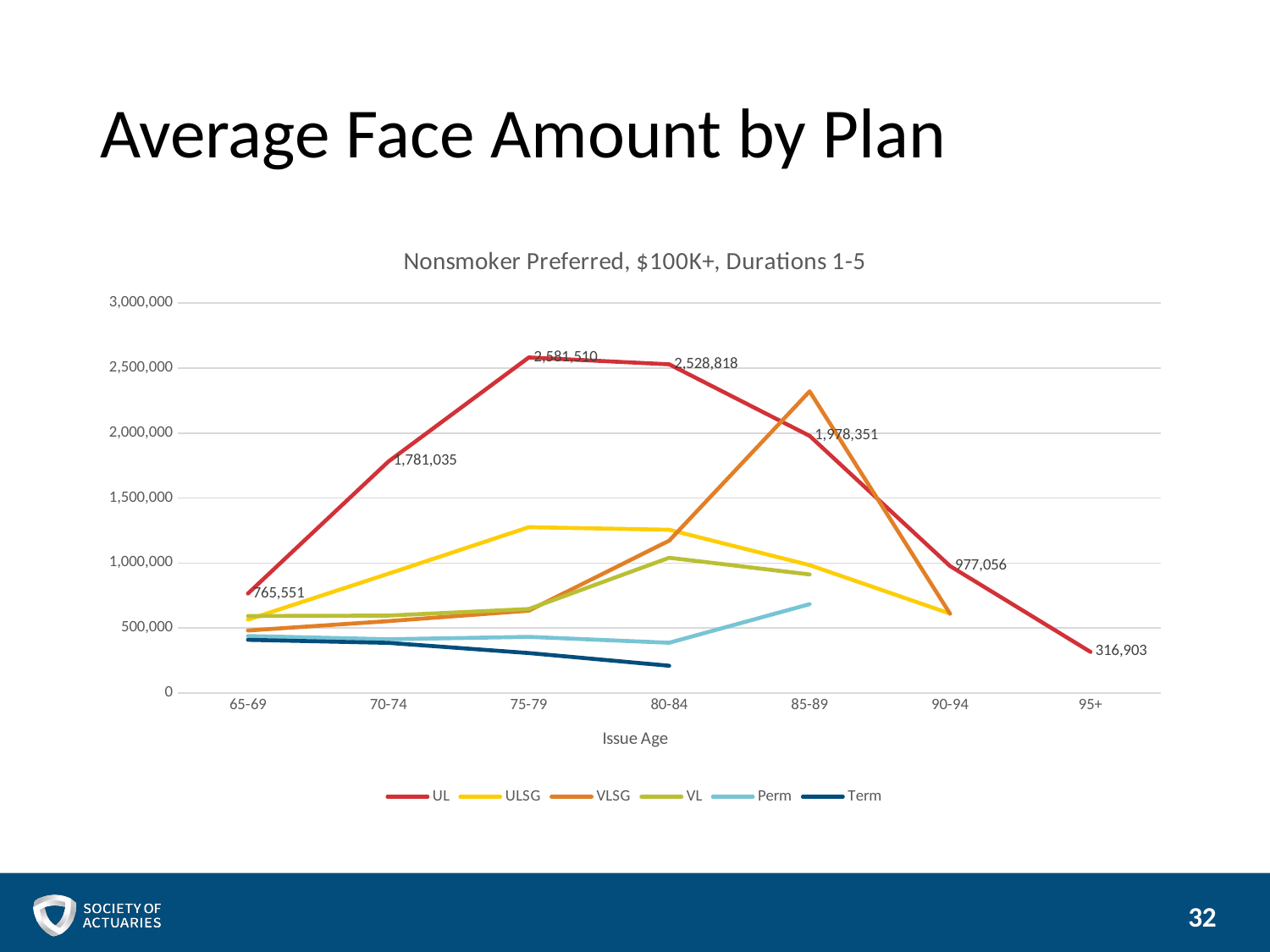
At which issue age does the UL series reach its highest value? 75-79 What is the value for UL at issue age 65-69? 765,551 What is the difference between the UL values at issue ages 80-84 and 85-89? 550,467 How many issue age categories are shown on the x axis? 7 What is the value for UL at issue age 95+? 316,903 Which is larger for UL: the value at issue age 70-74 or at 85-89? 85-89 What kind of chart is shown on the slide? line chart At which issue age does the UL series have its lowest value? 95+ What is the value for UL at issue age 90-94? 977,056 Is the value for VLSG at issue age 85-89 greater or less than 2,000,000? greater Is the value for Term at issue age 80-84 greater or less than 500,000? less How many series does the legend list? 6